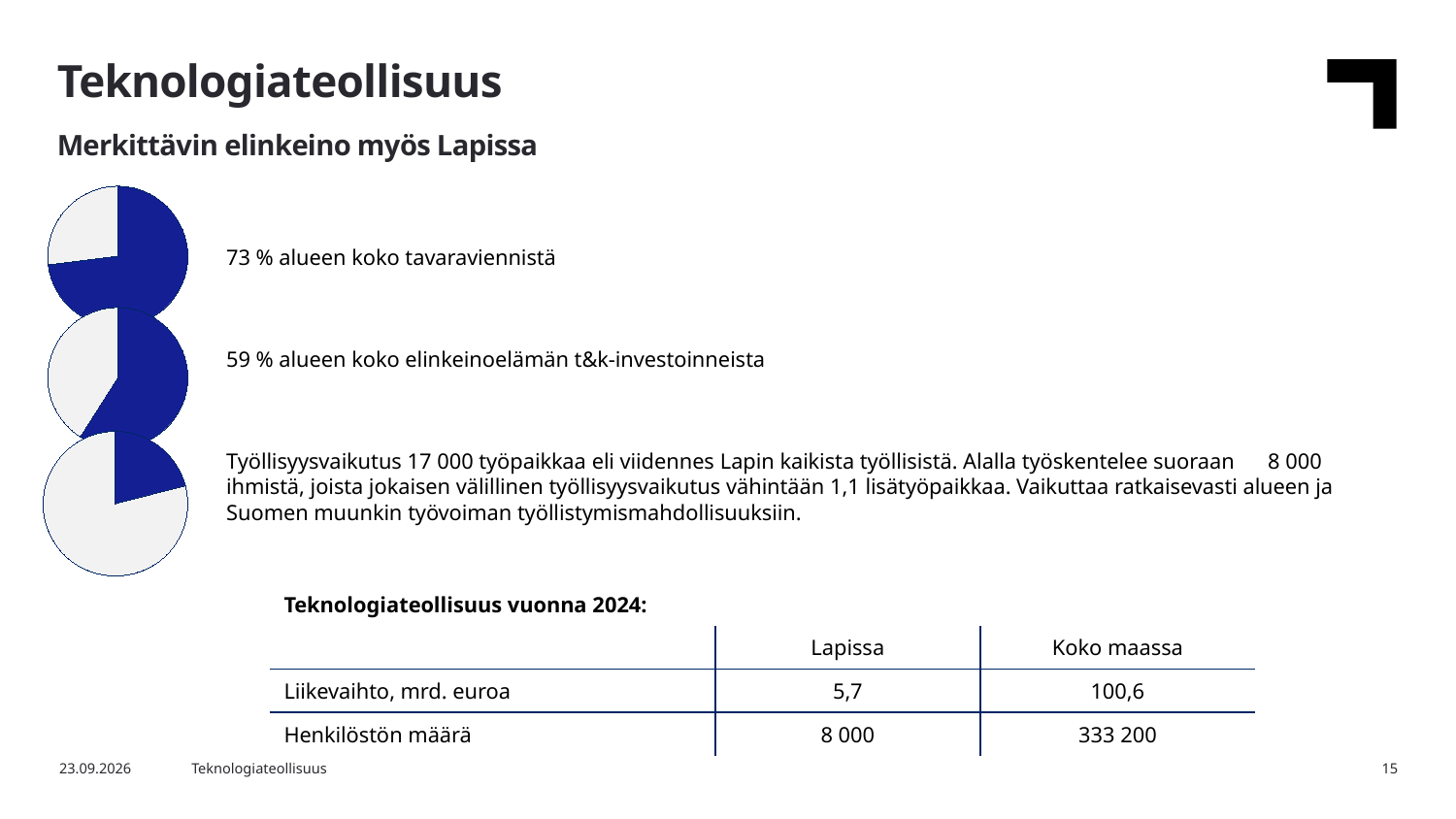
Which of the three pie charts has the smallest blue slice? The bottom pie chart What colour is used for the highlighted slice in the pie charts? Dark blue What kind of charts are shown on the left side of the slide? Pie charts How many slices does each pie chart have? 2 What is the difference between the shares shown for the top pie chart (73 %) and the middle pie chart (59 %)? 14 percentage points Which of the three pie charts has the largest blue slice? The top pie chart (73 %) Is the blue slice larger in the top pie chart or in the middle pie chart? The top pie chart According to the text next to the top pie chart, what share of the region's total goods exports does the blue slice represent? 73 % How many pie charts are on the slide? 3 According to the text next to the middle pie chart, what share of the region's business R&D investments does the blue slice represent? 59 % Is the blue slice of the top pie chart greater or less than 50%? greater Is the blue slice of the bottom pie chart greater or less than 50%? less